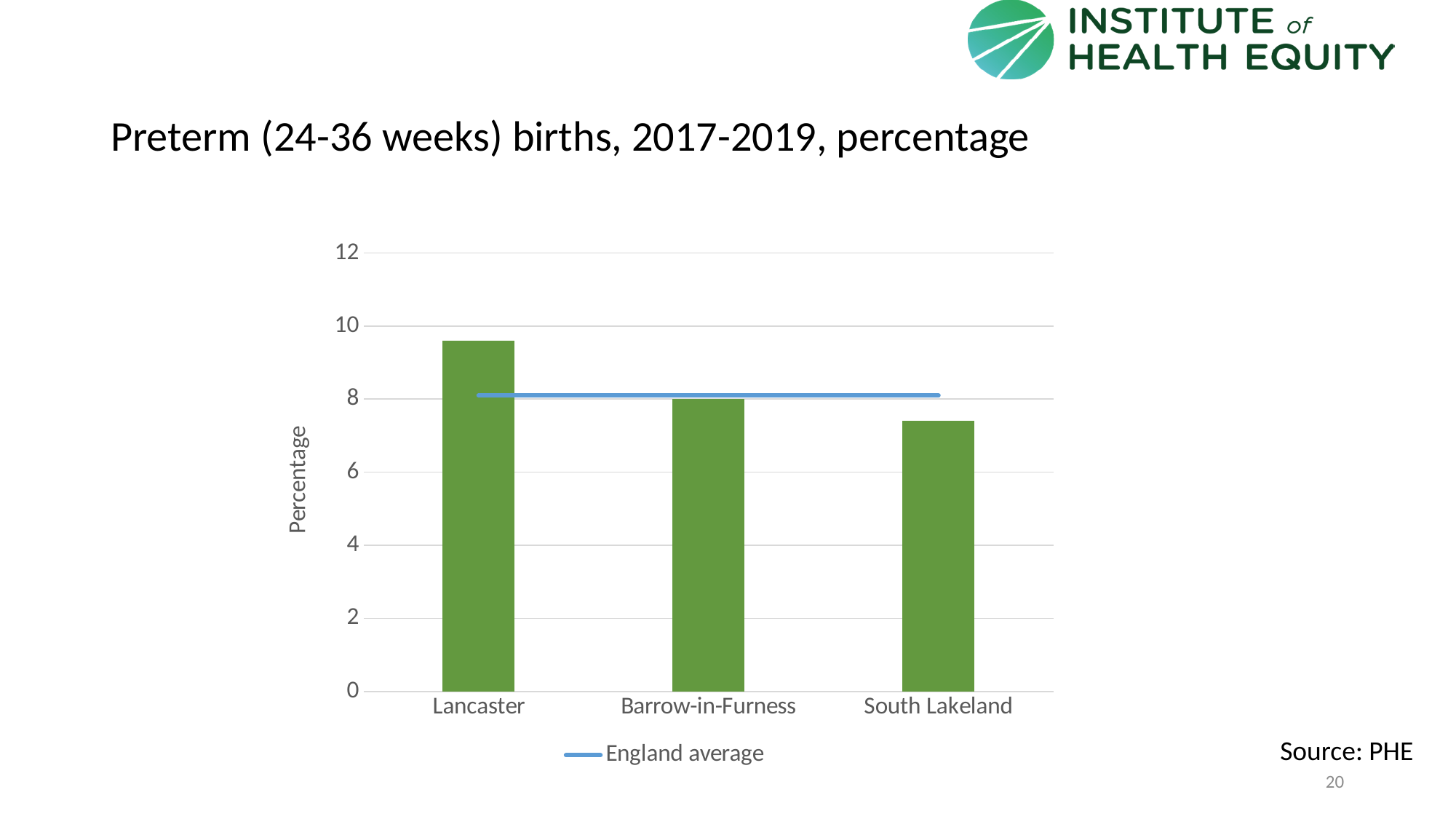
Which is larger, the value for Lancaster or the value for Barrow-in-Furness? Lancaster What is the label on the y axis? Percentage How many areas (categories) are plotted on the x axis? 3 Do the bar values rise or fall from left to right across the x axis? fall Is the value for Lancaster greater or less than 10? less Is the value for South Lakeland greater or less than 8? less Is the value for Lancaster greater or less than 8? greater Which area has the lowest percentage of preterm births? South Lakeland Which area has the highest percentage of preterm births? Lancaster Is the value for South Lakeland above or below the England average line? below What kind of chart is shown on the slide? Bar chart